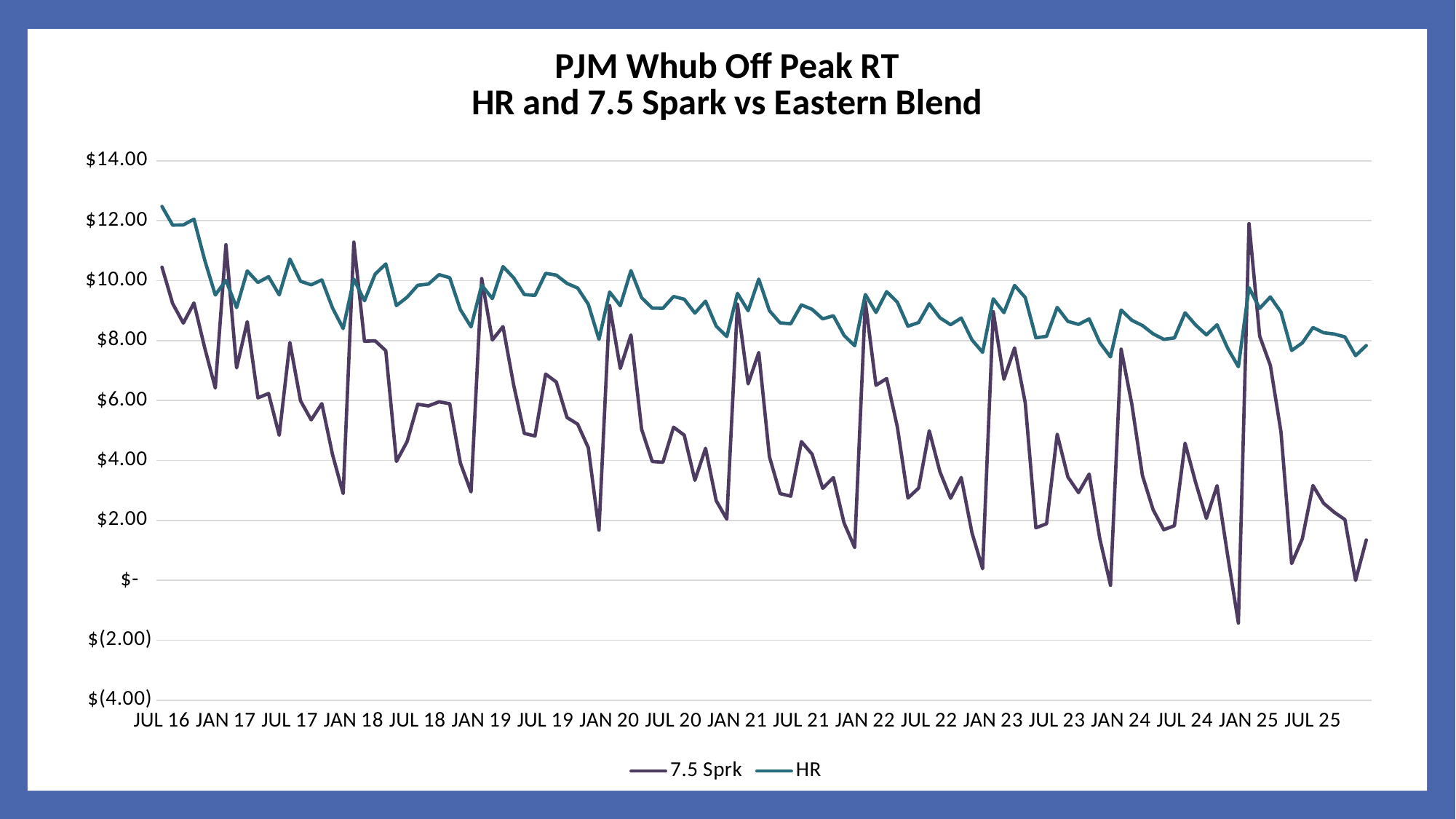
Is the HR value at JAN 25 greater or less than $8.00? greater Is the 7.5 Sprk value at JUL 16 greater or less than $10.00? greater At JUL 16, which series has the higher value, HR or 7.5 Sprk? HR Is the lowest 7.5 Sprk value on the chart greater or less than $-? less Which series stays higher across most of the chart, HR or 7.5 Sprk? HR What kind of chart is shown on the slide? Line chart Does the HR series generally rise or fall from JUL 16 to JUL 25? Fall What are the two series named in the legend? 7.5 Sprk and HR What is the title of the chart? PJM Whub Off Peak RT HR and 7.5 Spark vs Eastern Blend How many series does the legend list? 2 How many date labels are shown on the x axis? 19